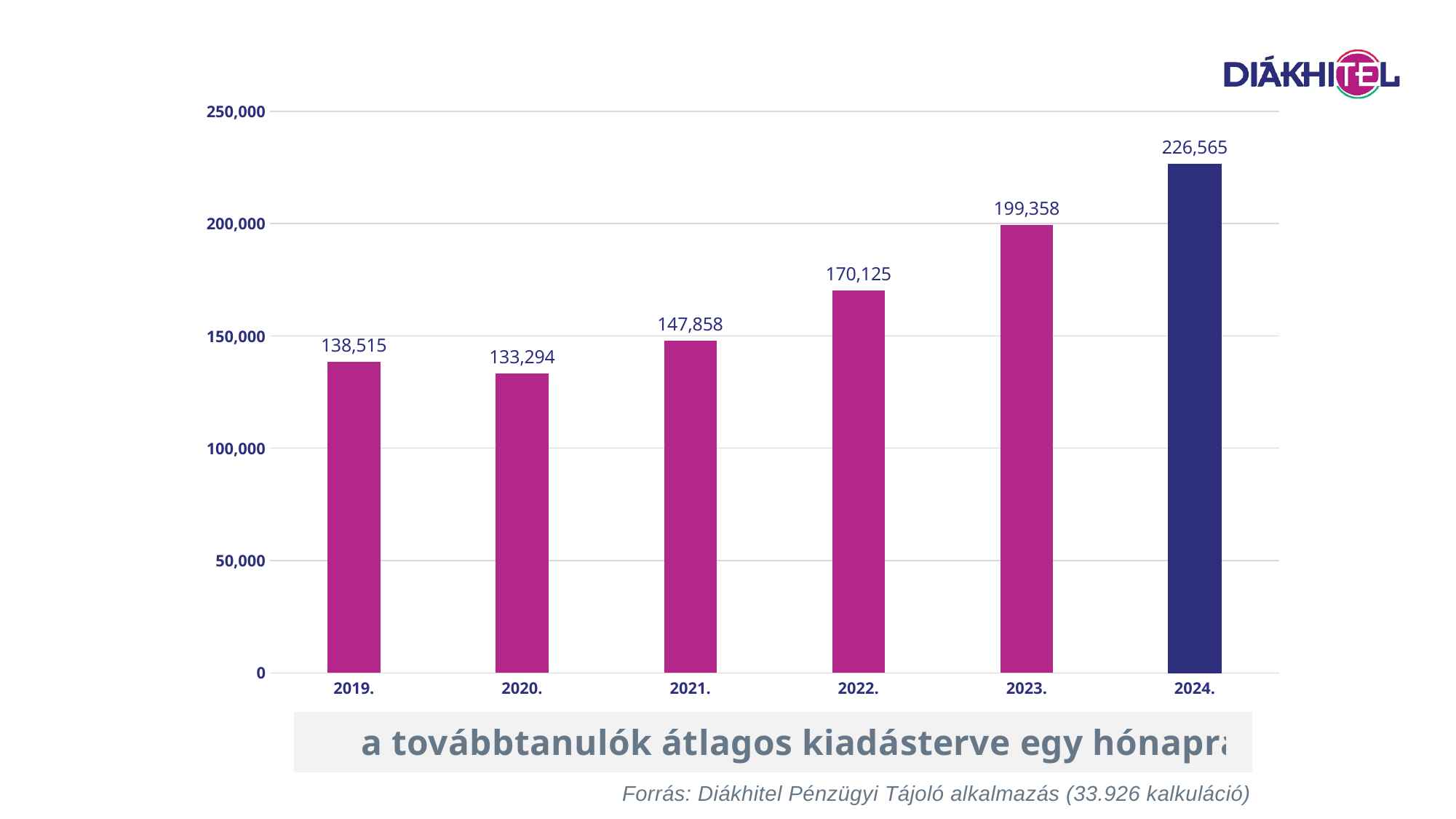
What is the difference between the values for 2024. and 2023.? 27,207 What is the difference between the values for 2021. and 2020.? 14,564 Is the value for 2023. greater or less than 200,000? less What is the value for 2024.? 226,565 What kind of chart is shown on the slide? bar chart Which year has the lowest value? 2020. What is the value for 2022.? 170,125 Which year has the highest value? 2024. How many years are shown on the x axis? 6 Which is larger, the value for 2019. or the value for 2020.? 2019. Which bar is coloured differently from the others? 2024. What is the value for 2019.? 138,515